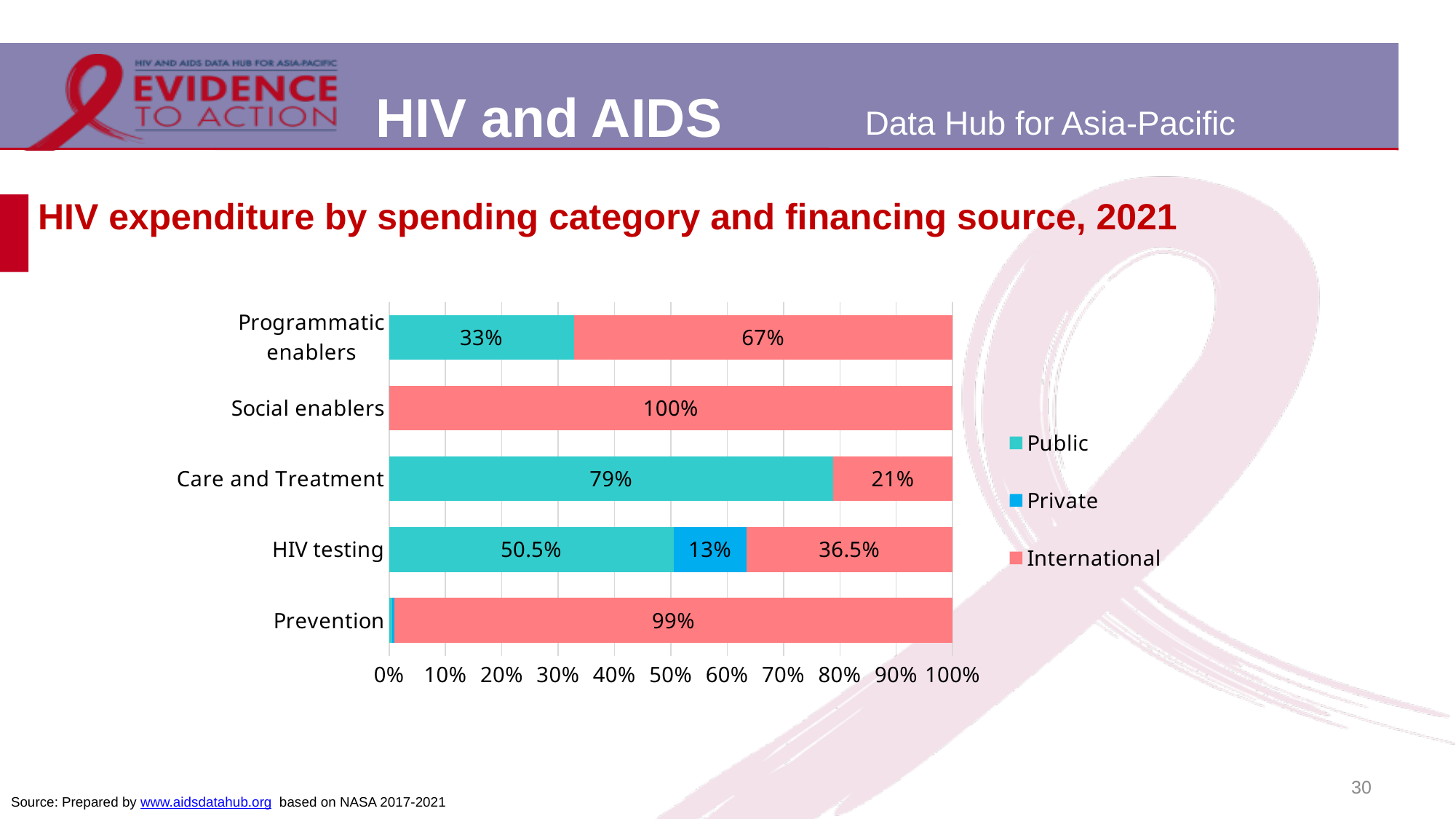
What is the International share of HIV expenditure for Social enablers? 100% What is the difference between the Public and International shares for HIV testing? 14% What is the International share of HIV expenditure for Programmatic enablers? 67% Which spending category has the highest Public share? Care and Treatment How many financing sources does the legend list? 3 Which spending category has the lowest International share? Care and Treatment How many spending categories are shown in the chart? 5 What kind of chart is shown on the slide? Stacked bar chart What is the Public share of HIV expenditure for Care and Treatment? 79% Is the Public share larger for Programmatic enablers or for HIV testing? HIV testing Is the International share for Prevention greater or less than 90%? greater What is the Private share of HIV expenditure for HIV testing? 13%